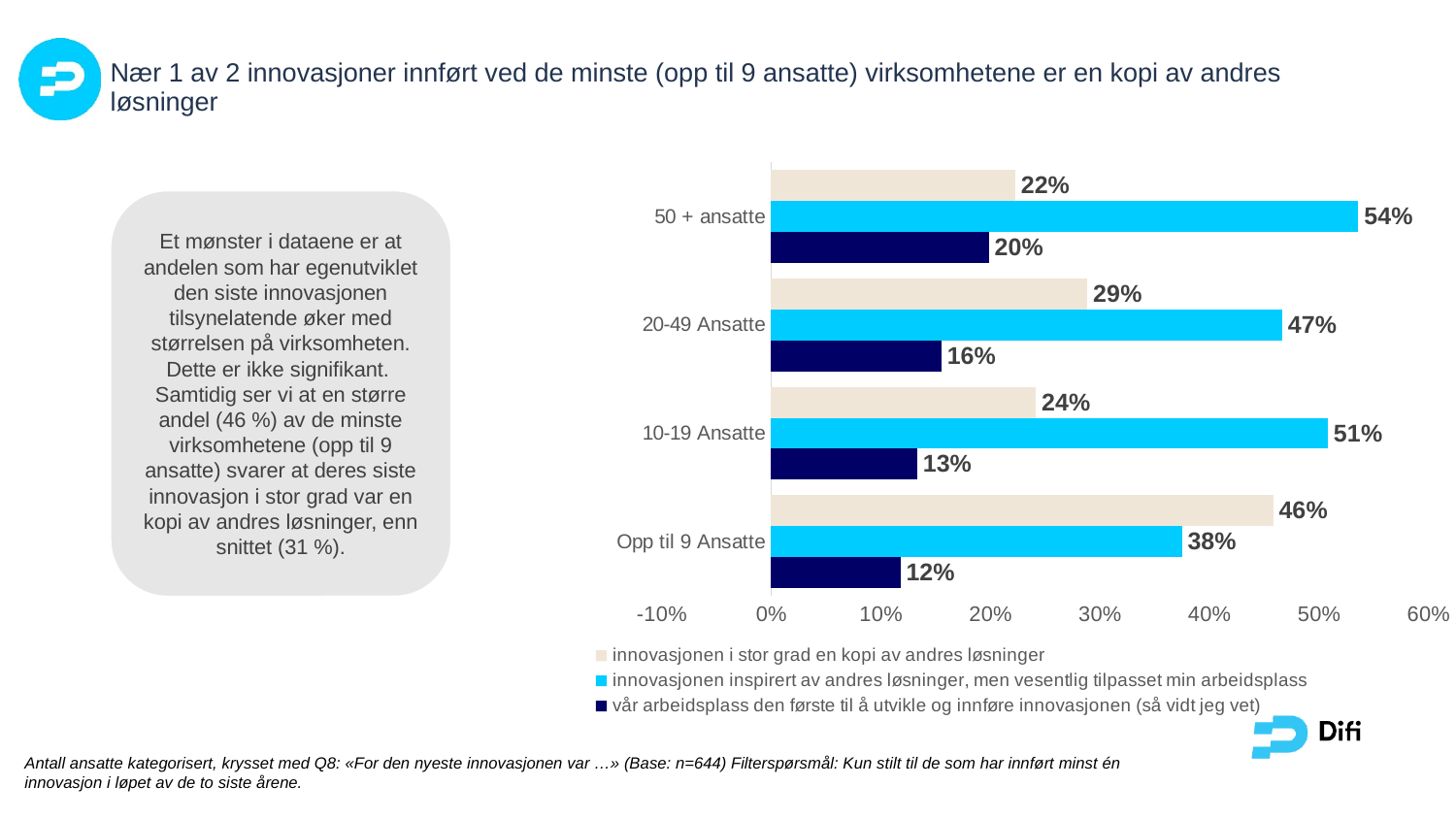
How many categories are shown on the chart? 4 What is the value for '50 + ansatte' in the series 'innovasjonen inspirert av andres løsninger, men vesentlig tilpasset min arbeidsplass'? 54% What colour are the bars for the series 'vår arbeidsplass den første til å utvikle og innføre innovasjonen (så vidt jeg vet)'? Dark blue What is the value for '20-49 Ansatte' in the series 'vår arbeidsplass den første til å utvikle og innføre innovasjonen (så vidt jeg vet)'? 16% What is the value for 'Opp til 9 Ansatte' in the series 'innovasjonen i stor grad en kopi av andres løsninger'? 46% How many series does the legend list? 3 Which category has the highest value in the series 'vår arbeidsplass den første til å utvikle og innføre innovasjonen (så vidt jeg vet)'? 50 + ansatte Which category has the lowest value in the series 'innovasjonen inspirert av andres løsninger, men vesentlig tilpasset min arbeidsplass'? Opp til 9 Ansatte What kind of chart is shown on the slide? Bar chart Is the value for '20-49 Ansatte' in the series 'innovasjonen inspirert av andres løsninger, men vesentlig tilpasset min arbeidsplass' greater or less than 40%? greater What is the difference between the 'innovasjonen i stor grad en kopi av andres løsninger' values for 'Opp til 9 Ansatte' and '50 + ansatte'? 24% Which is larger for '10-19 Ansatte': the value for 'innovasjonen i stor grad en kopi av andres løsninger' or the value for 'vår arbeidsplass den første til å utvikle og innføre innovasjonen (så vidt jeg vet)'? innovasjonen i stor grad en kopi av andres løsninger